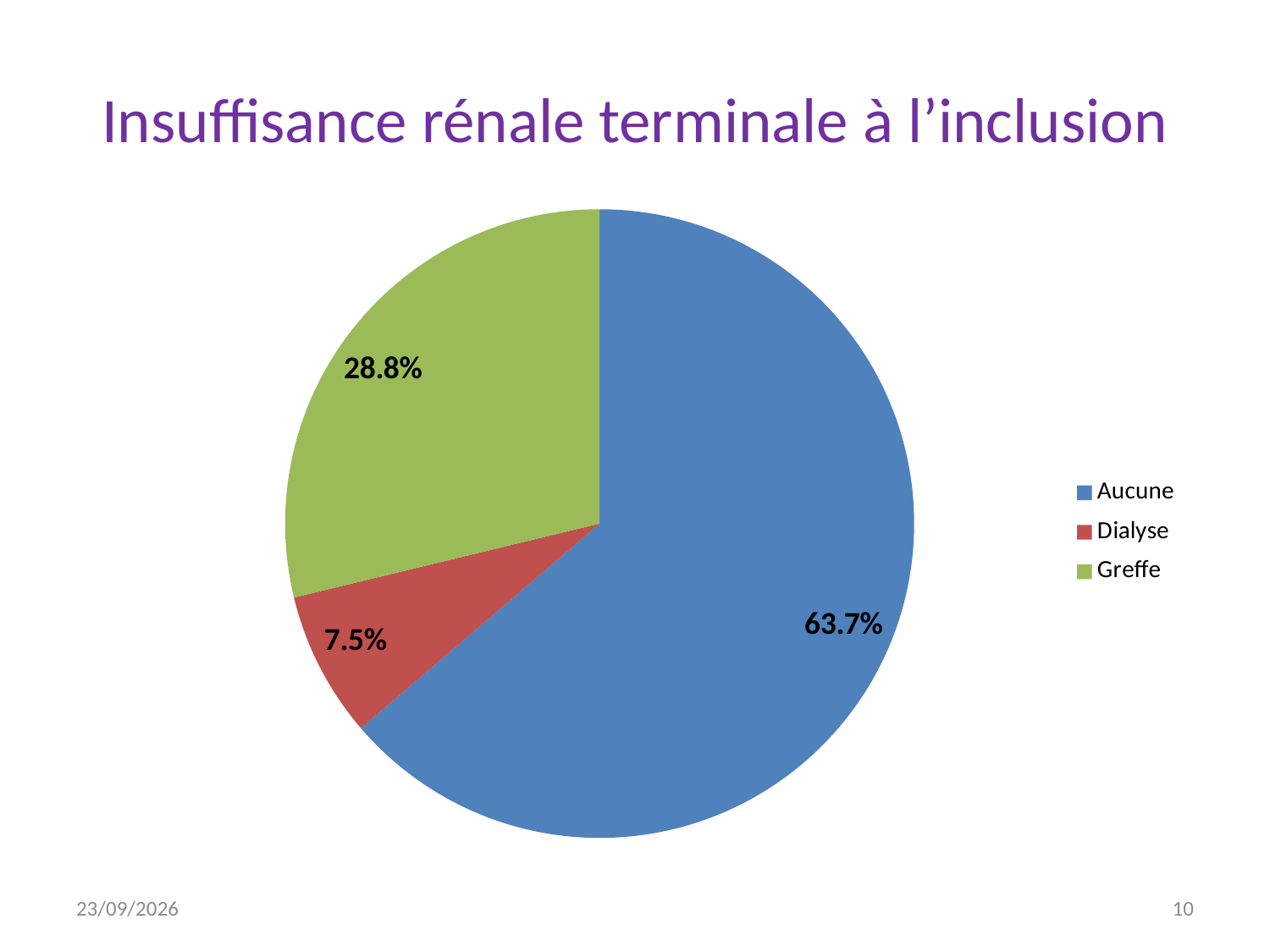
What percentage is shown for Dialyse? 7.5% What colour is the slice for Greffe? green Which category has the smallest slice of the pie? Dialyse What is the title of the chart? Insuffisance rénale terminale à l'inclusion What percentage is shown for Aucune? 63.7% What kind of chart is shown on the slide? pie chart What is the difference in percentage points between Greffe and Dialyse? 21.3 What percentage is shown for Greffe? 28.8% Which category has the largest slice of the pie? Aucune Which is larger, the share for Greffe or the share for Dialyse? Greffe How many categories does the legend list? 3 What is the difference in percentage points between Aucune and Greffe? 34.9